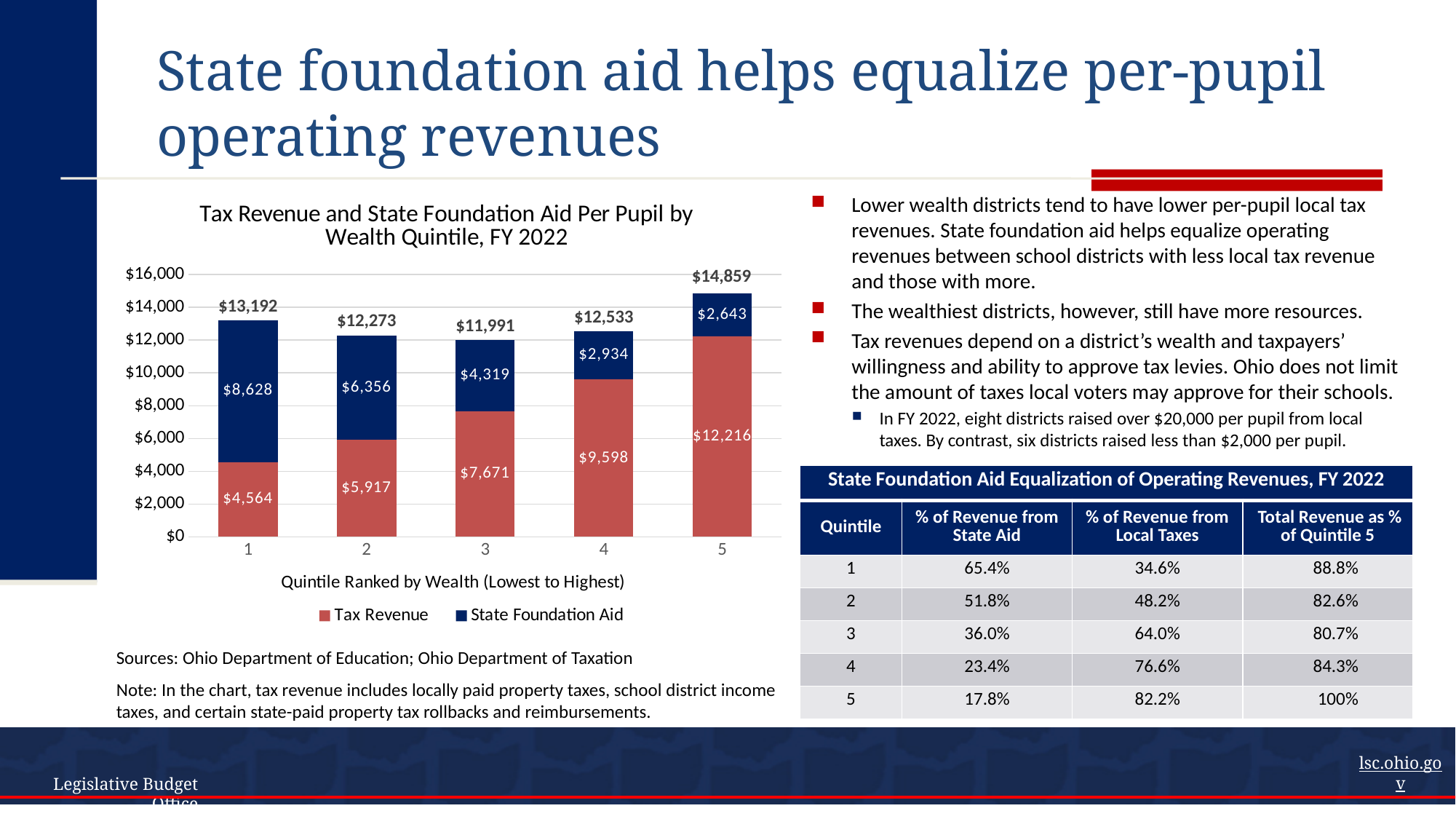
How does Tax Revenue per pupil change as the wealth quintile increases from 1 to 5? It rises Which quintile has the lowest State Foundation Aid per pupil? 5 How many series does the chart legend list? 2 What is the Tax Revenue per pupil for quintile 1? $4,564 Which quintile has the highest Tax Revenue per pupil? 5 What is the difference in Tax Revenue per pupil between quintile 5 and quintile 1? $7,652 Which is larger: State Foundation Aid for quintile 2 or Tax Revenue for quintile 2? State Foundation Aid Which quintile has the lowest combined total per pupil? 3 What is the total per-pupil revenue (tax revenue plus state foundation aid) shown for quintile 5? $14,859 How much more State Foundation Aid per pupil does quintile 1 receive than quintile 5? $5,985 What is the State Foundation Aid per pupil for quintile 3? $4,319 What type of chart is used to show Tax Revenue and State Foundation Aid Per Pupil by Wealth Quintile? Stacked bar chart